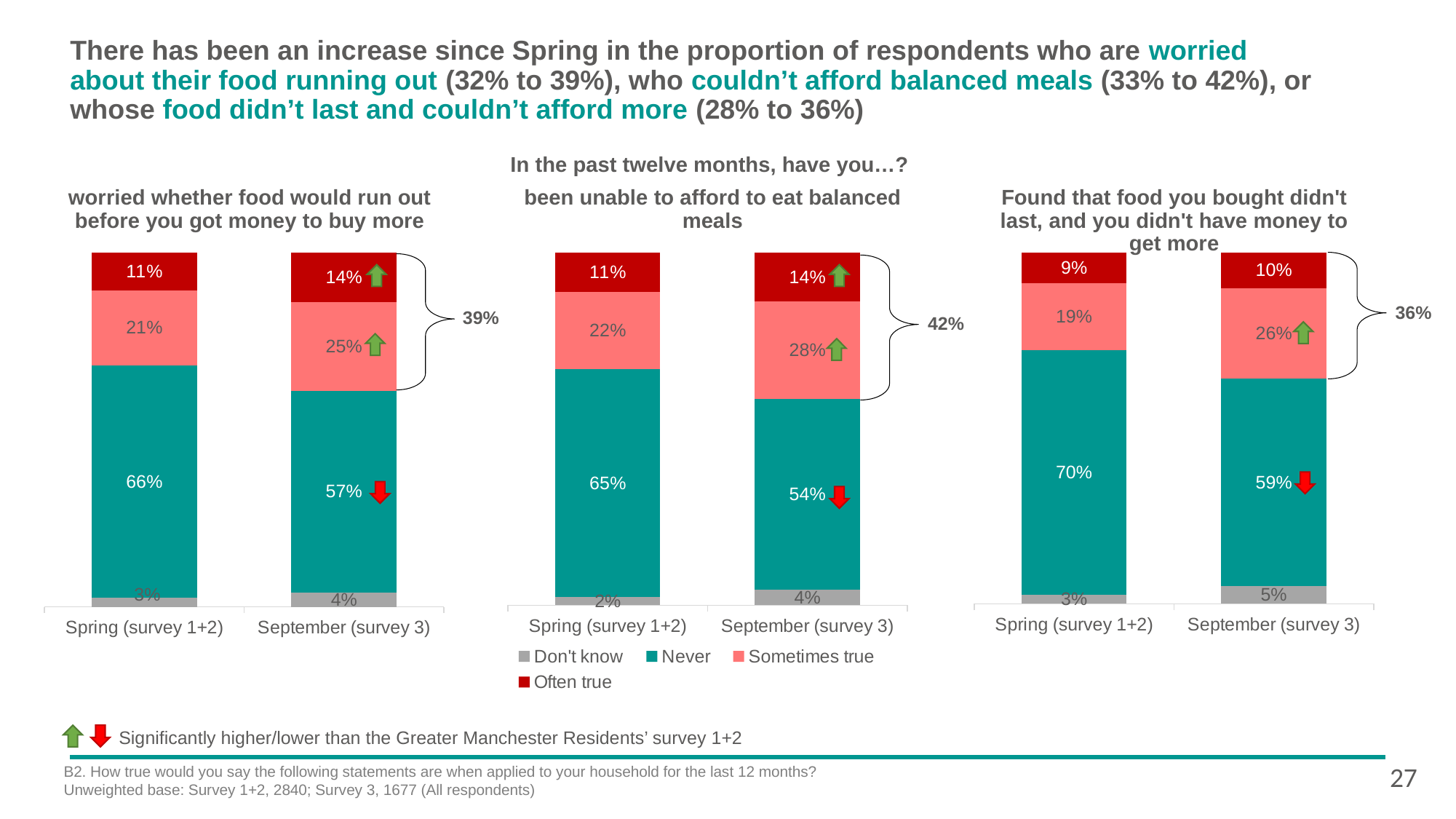
What kind of chart is used on this slide? Stacked bar chart In the chart 'worried whether food would run out before you got money to buy more', what is the 'Never' value for September (survey 3)? 57% In the chart 'worried whether food would run out before you got money to buy more', which period has the larger 'Sometimes true' value, Spring (survey 1+2) or September (survey 3)? September (survey 3) In the chart 'been unable to afford to eat balanced meals', what is the 'Sometimes true' value for September (survey 3)? 28% In the chart 'been unable to afford to eat balanced meals', which response category has the lowest value for Spring (survey 1+2)? Don't know In the chart 'worried whether food would run out before you got money to buy more', does the 'Never' value rise or fall from Spring (survey 1+2) to September (survey 3)? Fall In the chart 'Found that food you bought didn't last, and you didn't have money to get more', what is the combined total of 'Sometimes true' and 'Often true' for September (survey 3)? 36% In the chart 'been unable to afford to eat balanced meals', what is the difference between the 'Never' values for Spring (survey 1+2) and September (survey 3)? 11% In the chart 'Found that food you bought didn't last, and you didn't have money to get more', which response category has the highest value for September (survey 3)? Never In the chart 'Found that food you bought didn't last, and you didn't have money to get more', what is the 'Never' value for Spring (survey 1+2)? 70% In the chart 'worried whether food would run out before you got money to buy more', what is the 'Often true' value for Spring (survey 1+2)? 11% How many series does the legend list? 4